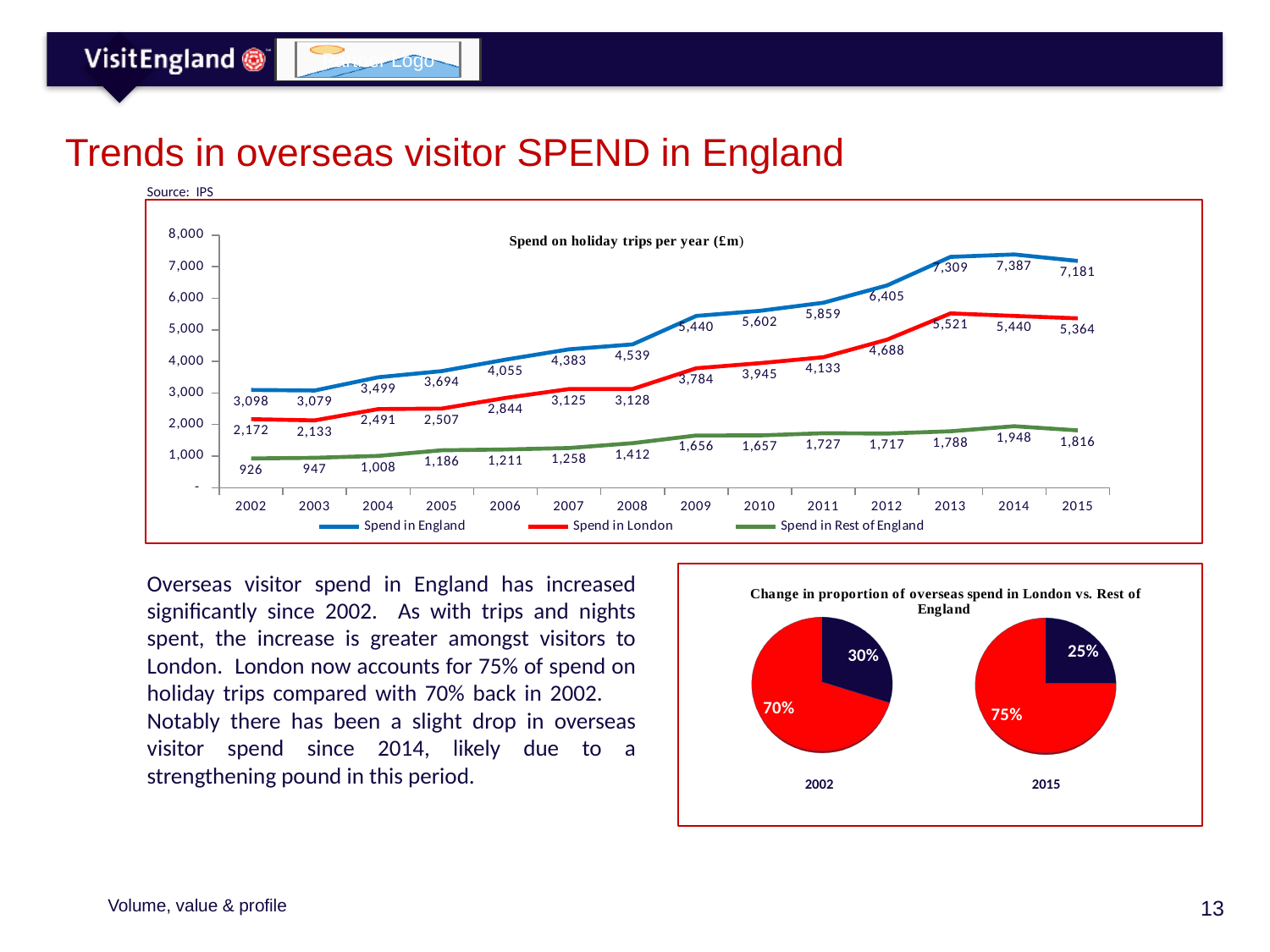
In the line chart, what is the difference between Spend in England and Spend in London in 2015? 1,817 How many years are shown on the x axis of the line chart? 14 In the line chart, was Spend in London higher in 2013 or 2014? 2013 In the line chart, did Spend in England rise or fall between 2002 and 2013? rise How many series does the legend of the line chart list? 3 What kind of chart is the 'Spend on holiday trips per year (£m)' chart? line chart In the line chart, what was the Spend in London in 2002? 2,172 In the line chart, in which year was Spend in Rest of England lowest? 2002 In the 2015 pie chart, what share does the larger (red) slice represent? 75% In the line chart, what was the Spend in England in 2015? 7,181 In the line chart, is the Spend in Rest of England for 2014 greater or less than 2,000? less In the line chart, in which year was Spend in England highest? 2014